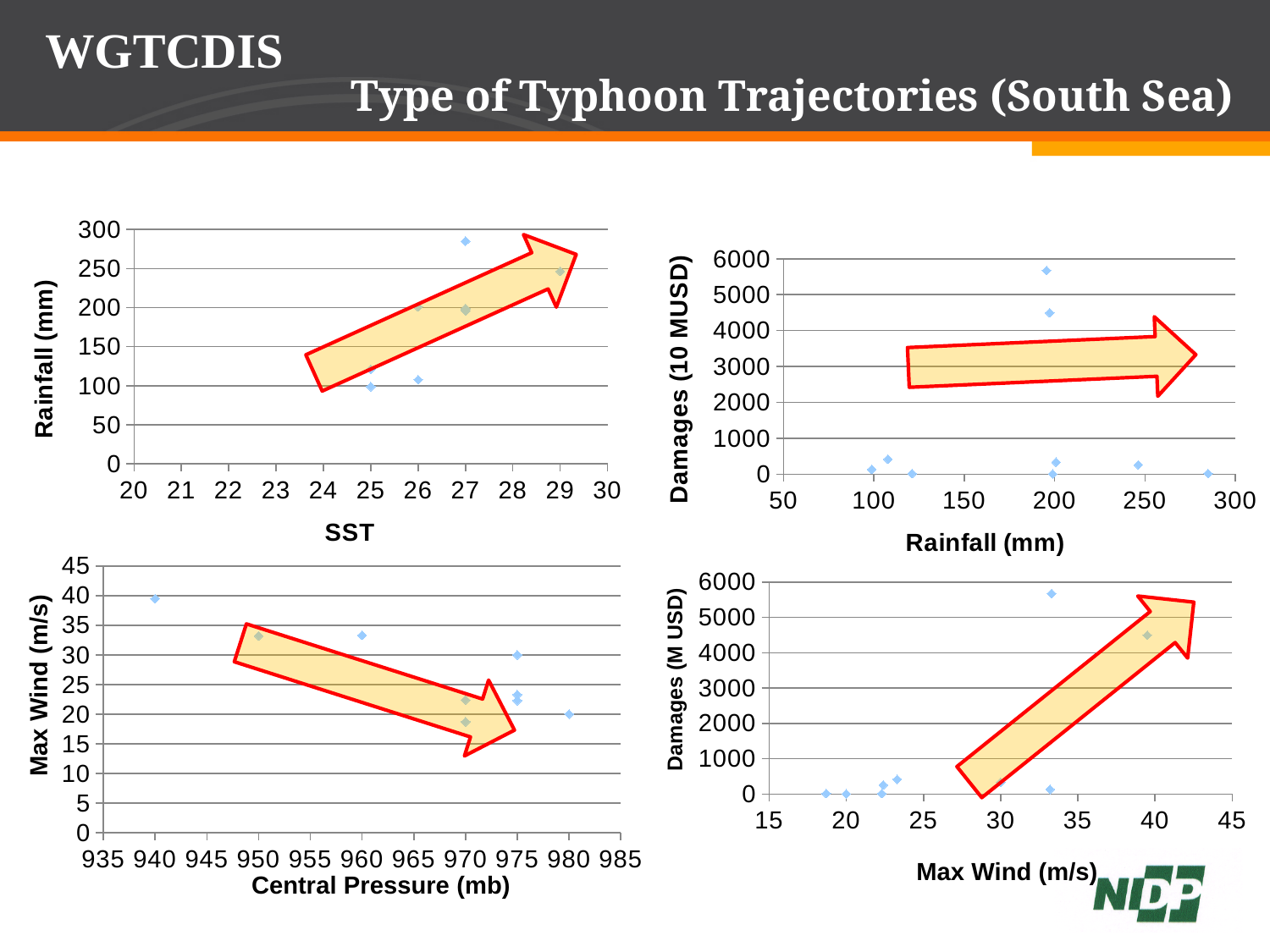
In the bottom-left chart (Max Wind vs Central Pressure), do the values generally rise or fall as central pressure increases? fall What is the x-axis label of the bottom-left chart? Central Pressure (mb) In the top-left chart (Rainfall vs SST), do the values generally rise or fall as SST increases? rise In the top-right chart (Damages vs Rainfall), is the highest damages value greater or less than 5000? greater In the bottom-right chart (Damages vs Max Wind), do the damages generally rise or fall as max wind increases? rise In the top-left chart, is the highest rainfall value plotted at SST 27 greater or less than 250? greater How many charts are shown on the slide? 4 In the bottom-left chart, is the max wind value at central pressure 980 greater or less than 25? less What kind of chart is the top-left chart with SST on the x axis? scatter chart What is the y-axis label of the top-right chart? Damages (10 MUSD)